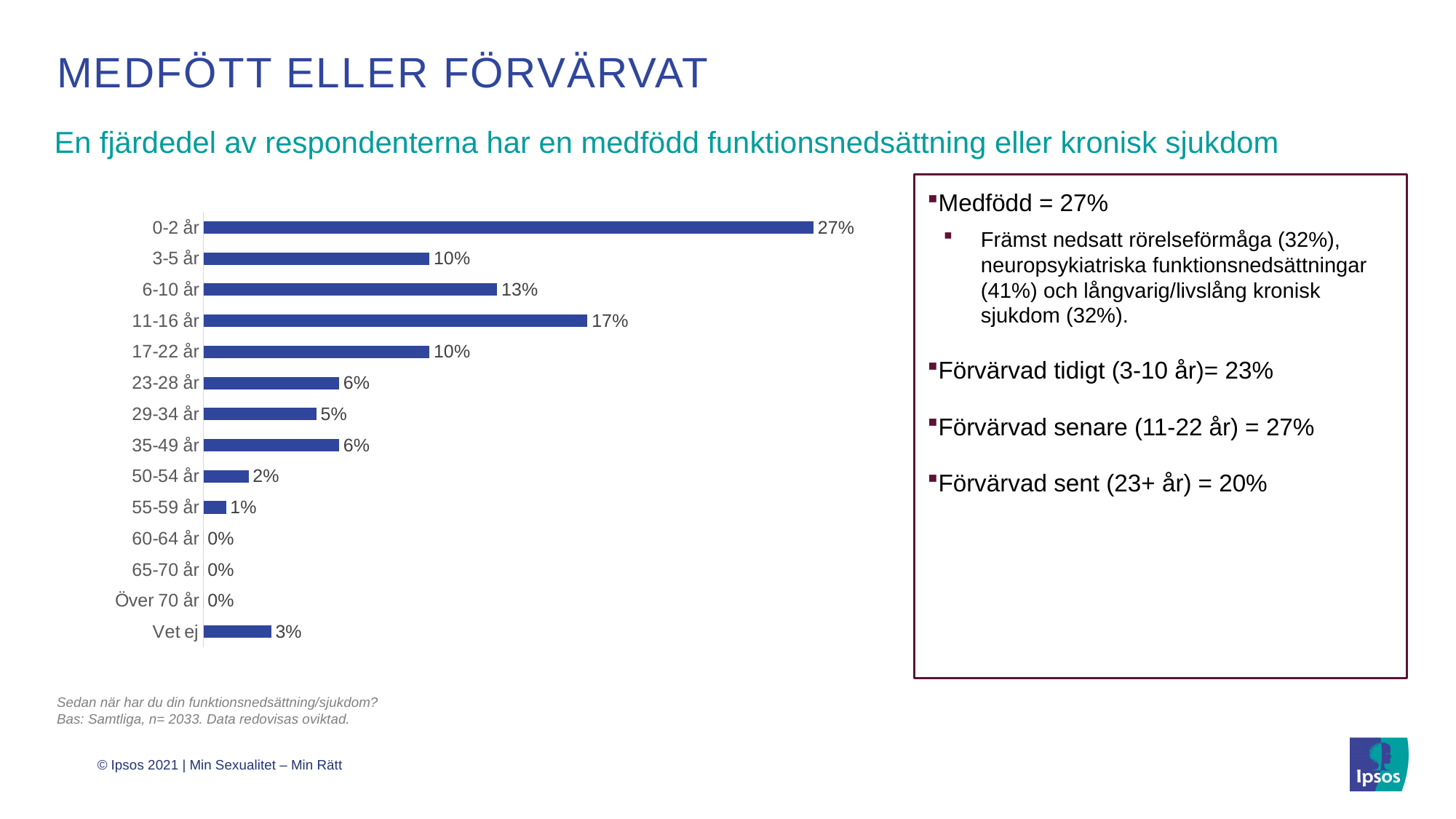
What is the value for the Vet ej category? 3% What is the value for the 0-2 år category? 27% Which is larger, the value for 23-28 år or the value for 29-34 år? 23-28 år What is the value for the 6-10 år category? 13% What kind of chart is shown on the slide? Bar chart What is the value for the 11-16 år category? 17% What is the difference between the values for 0-2 år and 11-16 år? 10% Which is larger, the value for 11-16 år or the value for 17-22 år? 11-16 år How many categories have a value of 0%? 3 What is the difference between the values for 6-10 år and 3-5 år? 3% How many categories are shown on the chart? 14 Which category has the highest value? 0-2 år